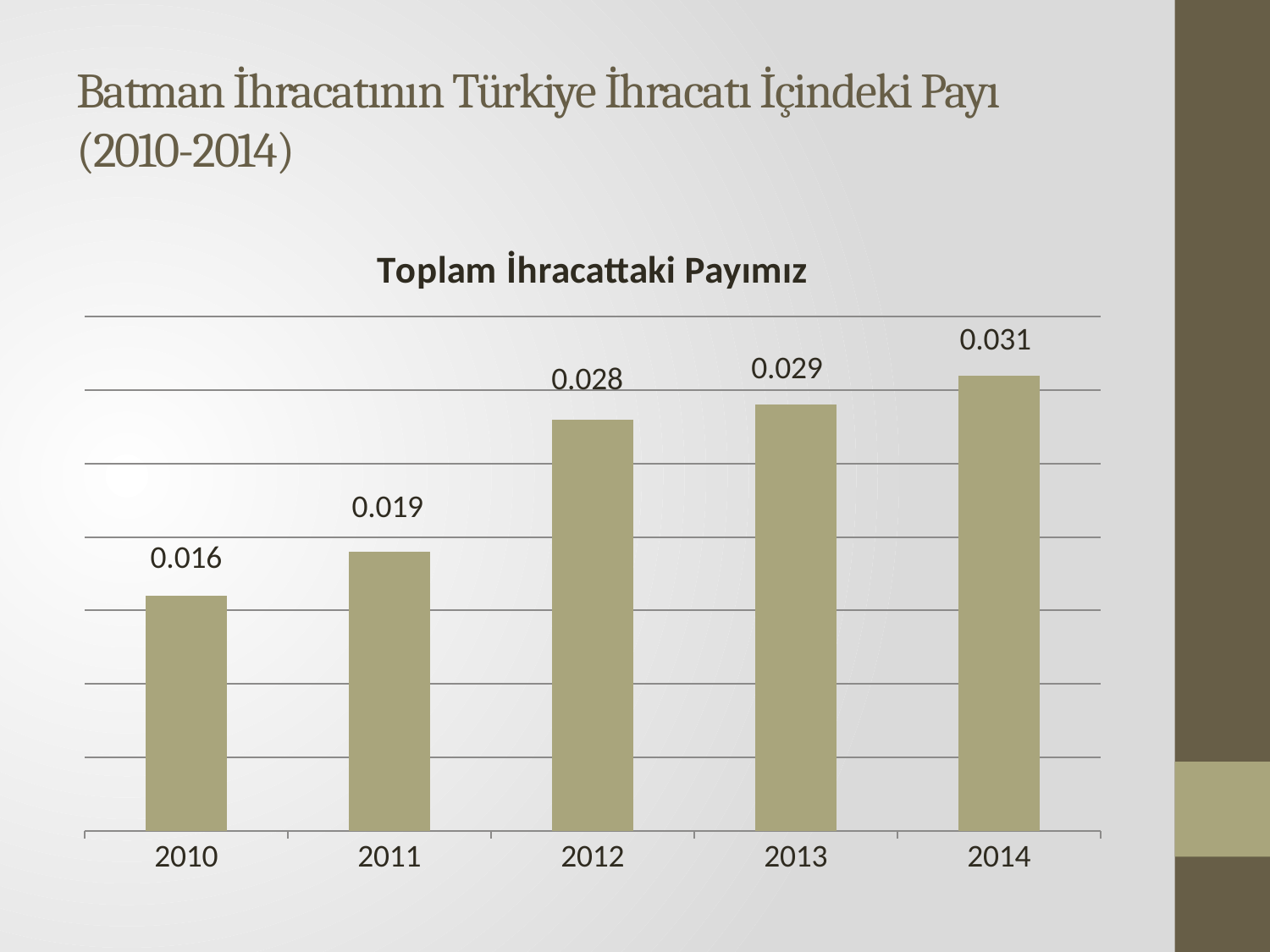
How many years are shown on the x axis? 5 What is the value for 2014? 0.031 Which year has the highest value? 2014 Which is larger, the value for 2011 or the value for 2013? 2013 Which year has the lowest value? 2010 Do the values rise or fall from 2010 to 2014? rise What is the title of the chart? Toplam İhracattaki Payımız What is the difference between the values for 2012 and 2011? 0.009 What is the value for 2012? 0.028 What kind of chart is this? bar chart What is the value for 2010? 0.016 What is the difference between the values for 2014 and 2010? 0.015